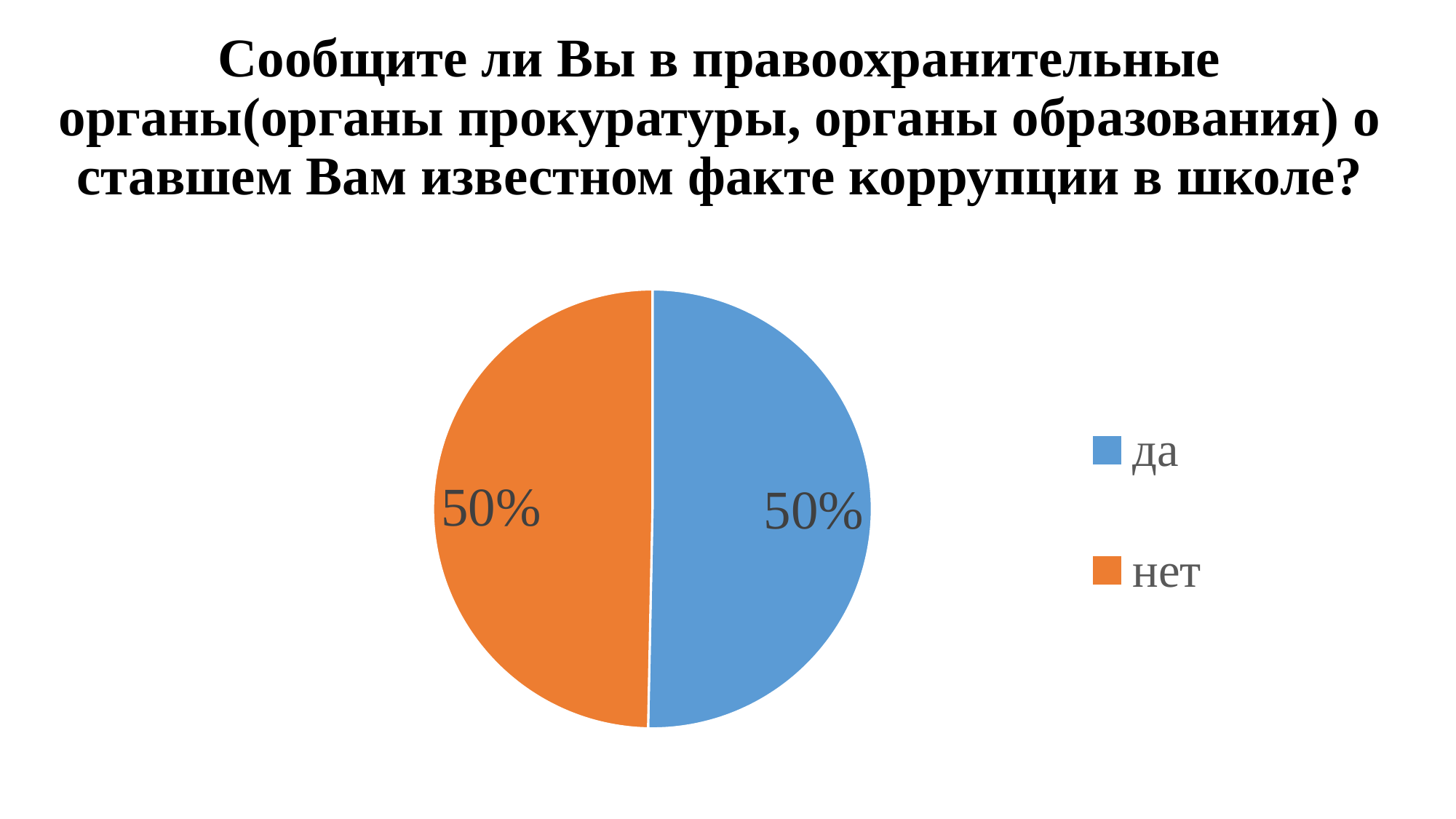
What kind of chart is shown on the slide? pie chart What is the value shown for the "нет" slice? 50% What share of the pie does "нет" represent? 50% What colour is the "нет" slice? orange What is the total of the two slices shown? 100% What share of the pie does "да" represent? 50% How many slices does the pie chart have? 2 What is the difference between the "да" and "нет" shares? 0% What is the value shown for the "да" slice? 50% What colour is the "да" slice? blue How many entries does the legend list? 2